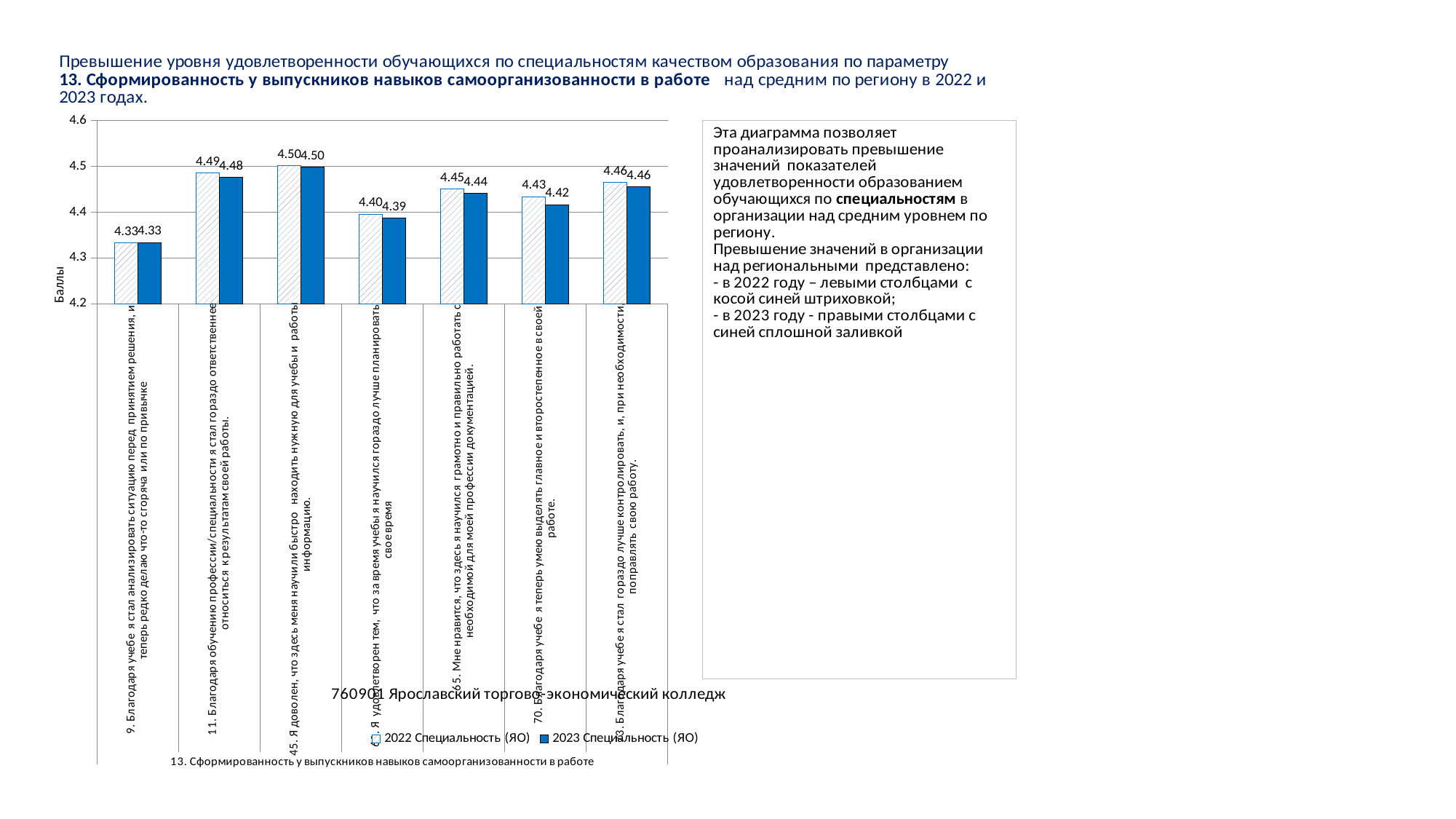
How many categories are shown on the x axis of the chart? 7 What is the label of the vertical axis of the chart? Баллы Which category has the highest 2022 Специальность (ЯО) value? 45. Я доволен, что здесь меня научили быстро находить нужную для учебы и работы информацию. What type of chart is shown on the slide? Bar chart What is the 2023 Специальность (ЯО) value for category 11 (Благодаря обучению профессии/специальности я стал гораздо ответственнее относиться к результатам своей работы)? 4.48 What is the 2022 Специальность (ЯО) value for category 70 (Благодаря учебе я теперь умею выделять главное и второстепенное в своей работе)? 4.43 What is the difference between the 2022 and 2023 Специальность (ЯО) values for category 65 (Мне нравится, что здесь я научился грамотно и правильно работать с необходимой для моей профессии документацией)? 0.01 Which is larger for category 73 (Благодаря учебе я стал гораздо лучше контролировать свою работу): the 2022 or the 2023 Специальность (ЯО) value? They are equal (4.46) What is the 2022 Специальность (ЯО) value for category 9 (Благодаря учебе я стал анализировать ситуацию перед принятием решения)? 4.33 Which category has the lowest 2023 Специальность (ЯО) value? 9. Благодаря учебе я стал анализировать ситуацию перед принятием решения, и теперь редко делаю что-то сгоряча или по привычке How many series does the chart legend list? 2 Is the 2023 Специальность (ЯО) value for category 9 greater or less than 4.4? less